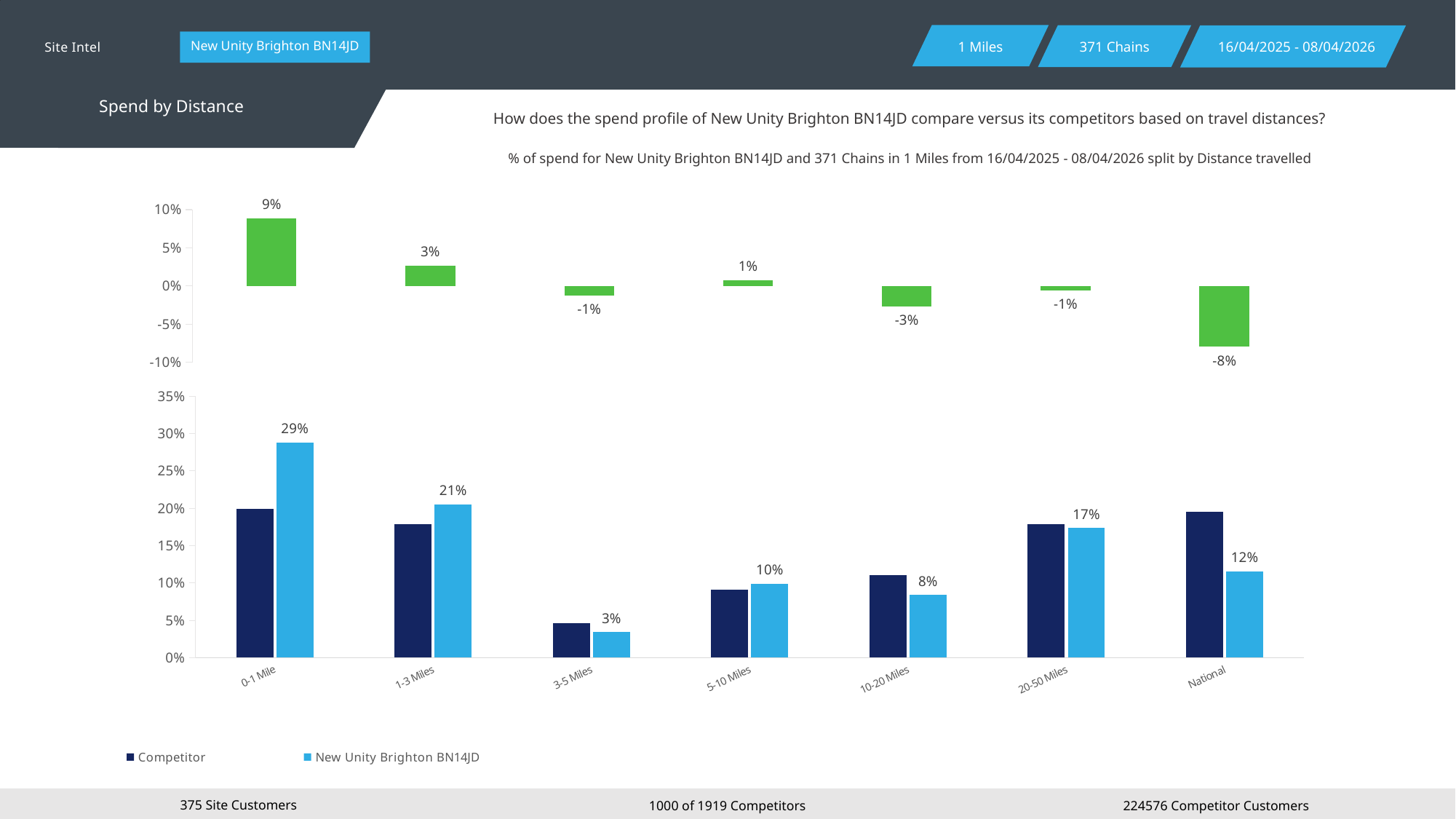
In the bottom chart, what is the difference between the New Unity Brighton BN14JD values for 0-1 Mile and 1-3 Miles? 8% In the top chart, which category has the lowest value? National How many categories are shown on the x axis of the bottom chart? 7 In the top chart, which category has the highest value? 0-1 Mile In the bottom chart, which is larger in the 10-20 Miles category: Competitor or New Unity Brighton BN14JD? Competitor How many series does the legend of the bottom chart list? 2 In the bottom chart, is the Competitor value for National greater or less than 15%? greater In the top chart, what is the value for the National category? -8% In the top chart, what is the value for the 10-20 Miles category? -3% In the bottom chart, what is the value for New Unity Brighton BN14JD in the 20-50 Miles category? 17% In the bottom chart, which category has the lowest value for New Unity Brighton BN14JD? 3-5 Miles In the bottom chart, what is the value for New Unity Brighton BN14JD in the 0-1 Mile category? 29%